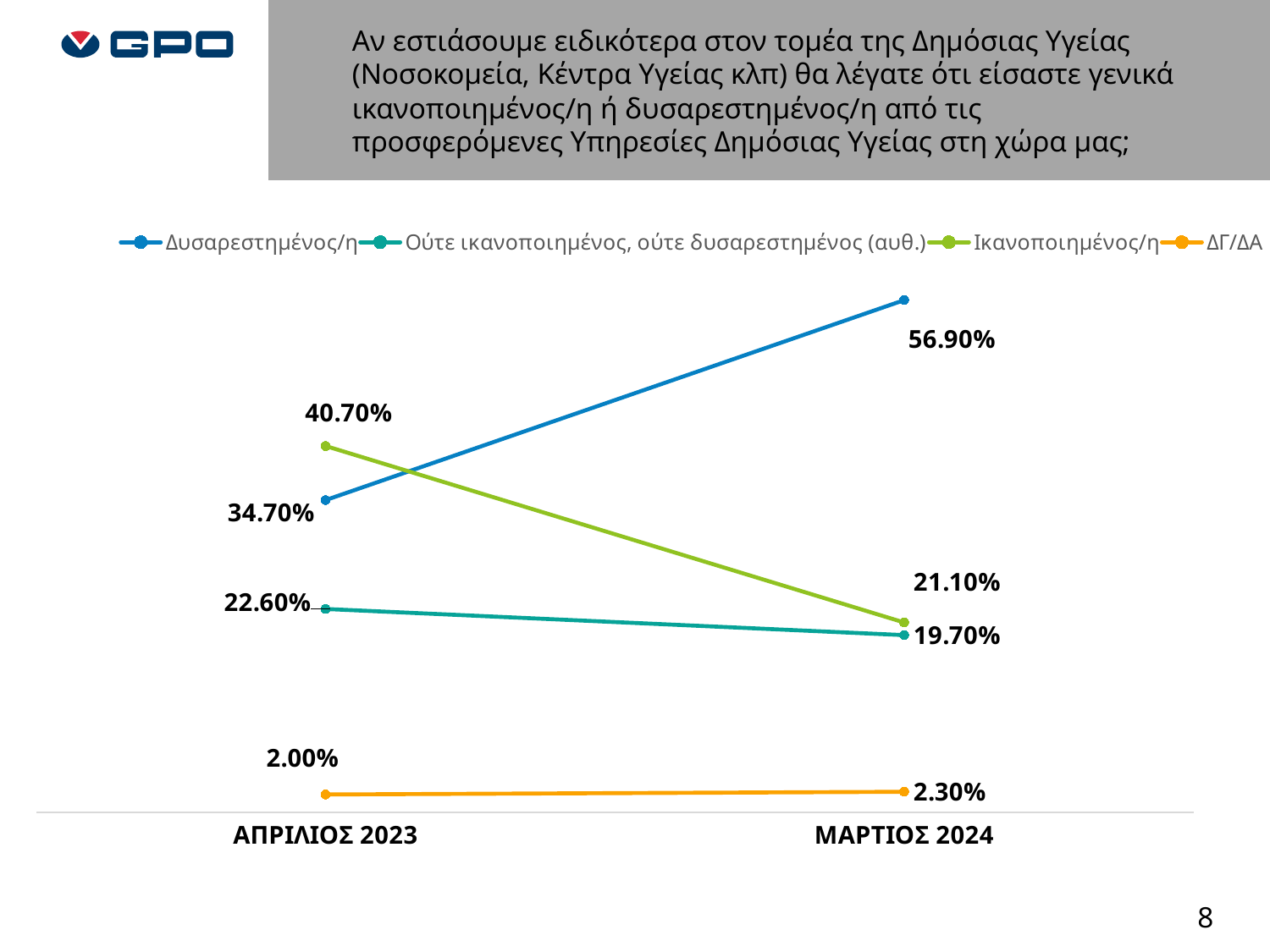
How many time points are shown on the x axis? 2 Which series has the lowest value in ΑΠΡΙΛΙΟΣ 2023? ΔΓ/ΔΑ What is the value for Ικανοποιημένος/η in ΑΠΡΙΛΙΟΣ 2023? 40.70% What is the value for Δυσαρεστημένος/η in ΜΑΡΤΙΟΣ 2024? 56.90% How many series does the legend list? 4 What is the value for ΔΓ/ΔΑ in ΜΑΡΤΙΟΣ 2024? 2.30% What is the value for Ούτε ικανοποιημένος, ούτε δυσαρεστημένος (αυθ.) in ΑΠΡΙΛΙΟΣ 2023? 22.60% Which series has the highest value in ΜΑΡΤΙΟΣ 2024? Δυσαρεστημένος/η Does the value for Ικανοποιημένος/η rise or fall from ΑΠΡΙΛΙΟΣ 2023 to ΜΑΡΤΙΟΣ 2024? fall Which is larger in ΑΠΡΙΛΙΟΣ 2023: Δυσαρεστημένος/η or Ικανοποιημένος/η? Ικανοποιημένος/η What kind of chart is shown on the slide? line chart By how much did the value for Δυσαρεστημένος/η change from ΑΠΡΙΛΙΟΣ 2023 to ΜΑΡΤΙΟΣ 2024? 22.20%